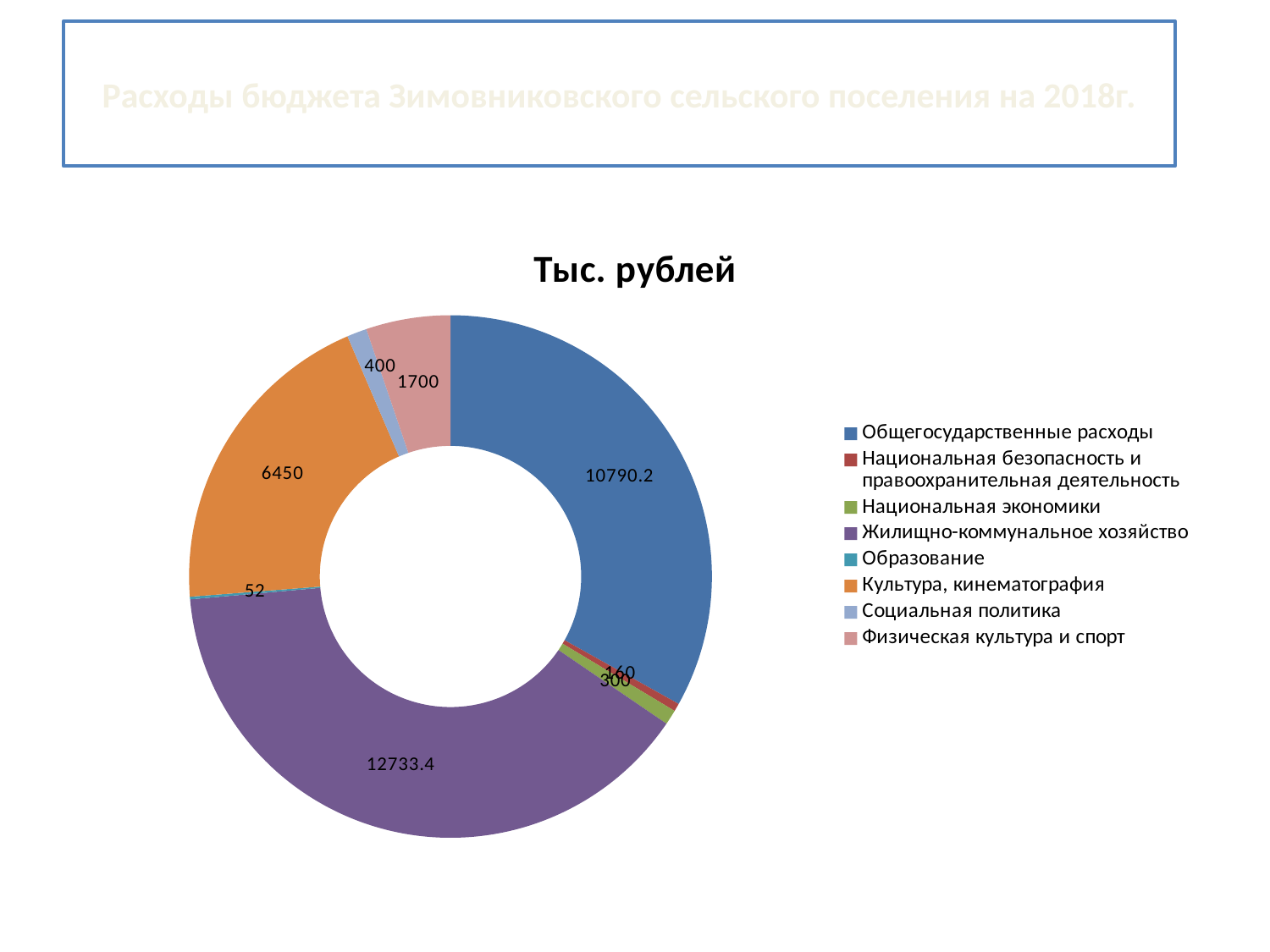
How many categories does the legend of the chart list? 8 Which category has the smallest value in the chart? Образование What kind of chart is shown on the slide? Doughnut (pie) chart What is the difference between the values for Жилищно-коммунальное хозяйство and Общегосударственные расходы? 1943.2 What is the value for Жилищно-коммунальное хозяйство? 12733.4 Which is larger: Культура, кинематография or Физическая культура и спорт? Культура, кинематография What is the value for Физическая культура и спорт? 1700 What is the value for Образование? 52 What is the value for Культура, кинематография? 6450 What is the value for Социальная политика? 400 Which category has the largest value in the chart? Жилищно-коммунальное хозяйство What is the value for Общегосударственные расходы? 10790.2